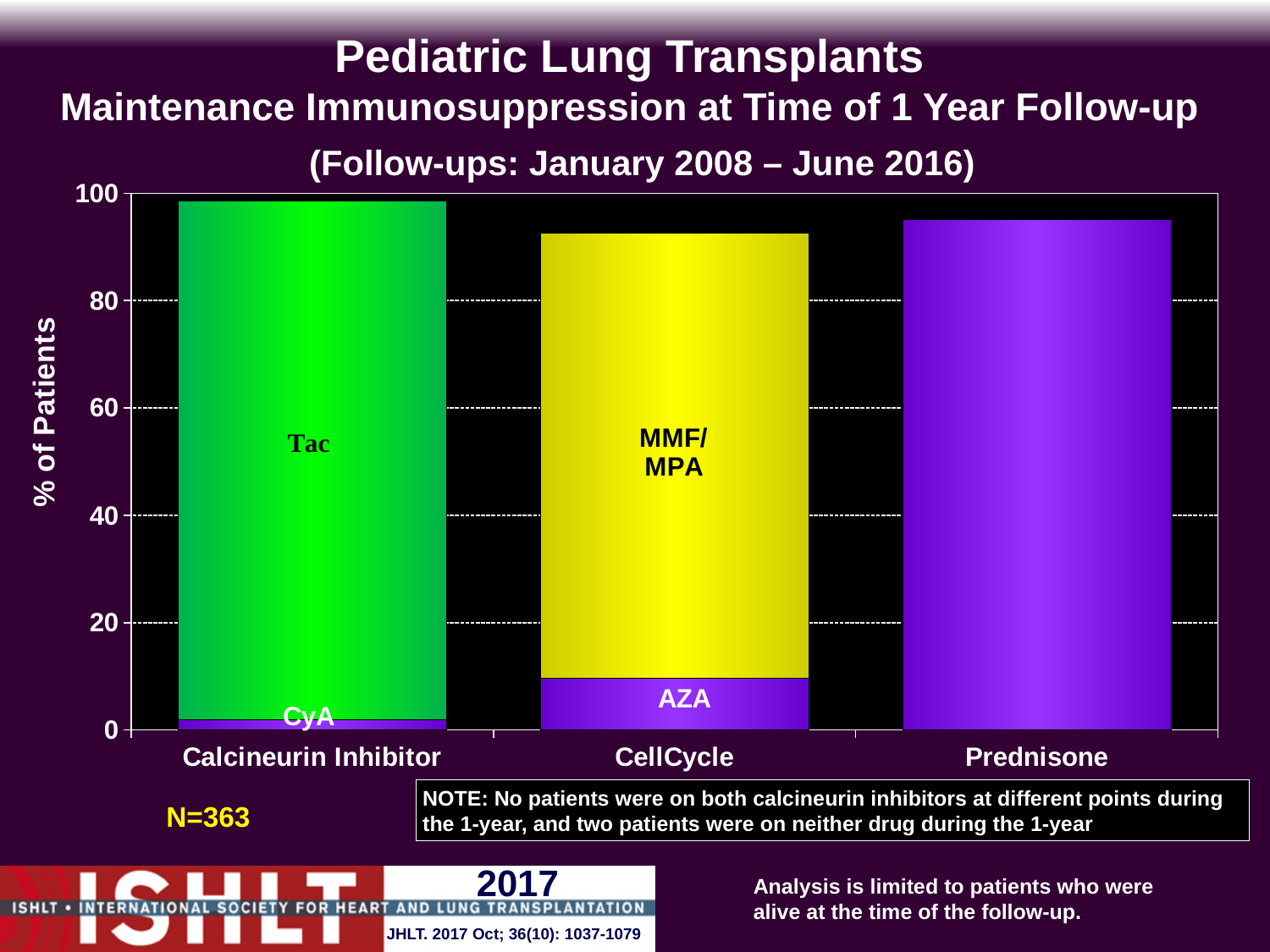
Which segment is larger in the Calcineurin Inhibitor bar, Tac or CyA? Tac What is the label of the y axis of the chart? % of Patients Is the value for the Tac segment in the Calcineurin Inhibitor bar greater or less than 80? greater What is the N value shown on the slide for the chart? N=363 Is the value for the AZA segment in the CellCycle bar greater or less than 20? less Is the value for the CyA segment in the Calcineurin Inhibitor bar greater or less than 20? less Which segment is larger in the CellCycle bar, MMF/MPA or AZA? MMF/MPA How many categories are shown on the x axis of the chart? 3 Which segment in the chart is the smallest? CyA What kind of chart is shown on the slide? stacked bar chart